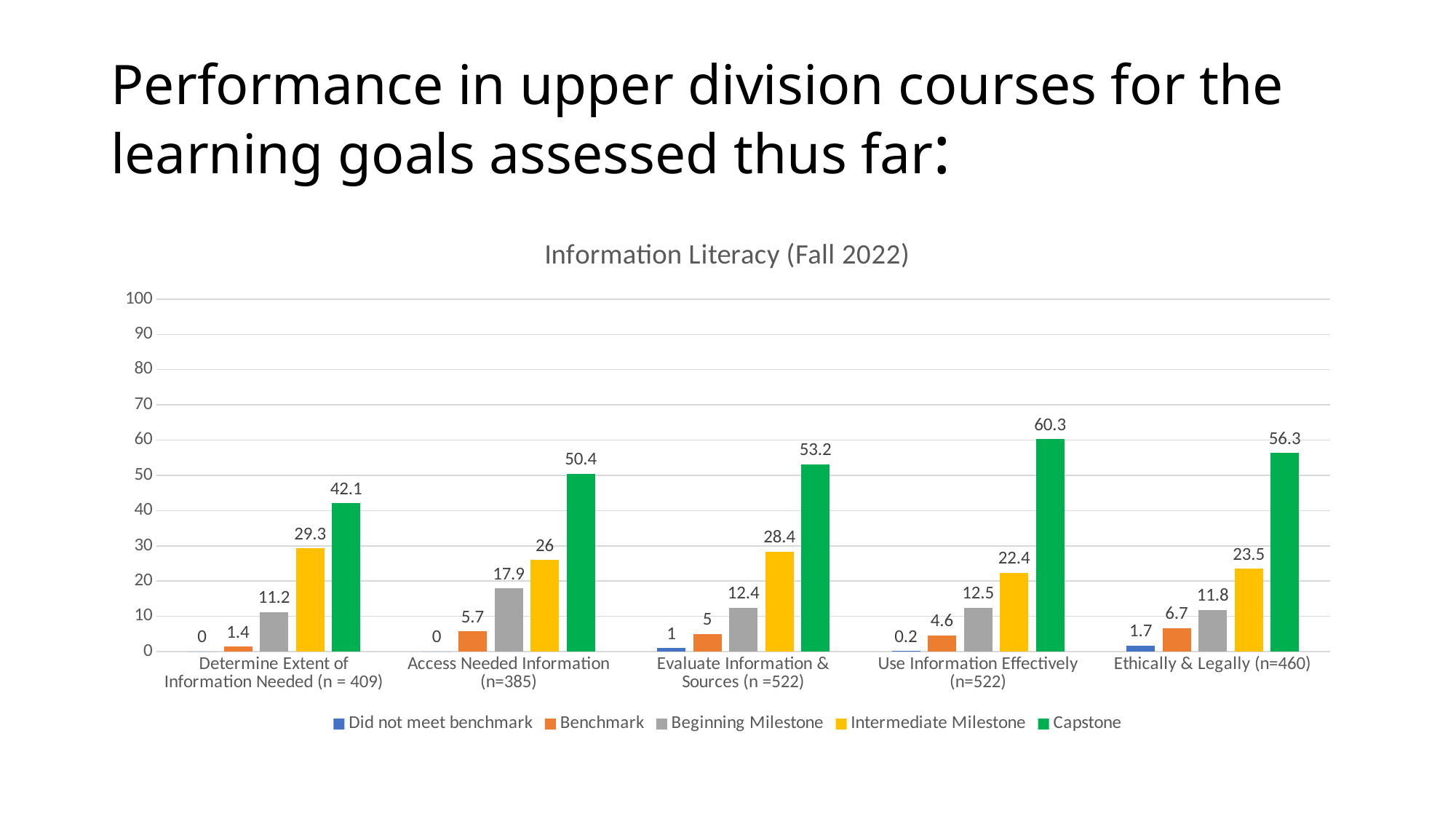
How many categories are shown on the x axis? 5 What is the Capstone value for Use Information Effectively (n=522)? 60.3 How many series does the legend list? 5 What is the Beginning Milestone value for Ethically & Legally (n=460)? 11.8 Which is larger: the Intermediate Milestone value for Determine Extent of Information Needed (n = 409) or for Evaluate Information & Sources (n =522)? Determine Extent of Information Needed (n = 409) Which category has the lowest Capstone value? Determine Extent of Information Needed (n = 409) What is the Intermediate Milestone value for Access Needed Information (n=385)? 26 What is the difference between the Capstone values for Use Information Effectively (n=522) and Determine Extent of Information Needed (n = 409)? 18.2 What is the title of the chart? Information Literacy (Fall 2022) Which category has the highest Capstone value? Use Information Effectively (n=522) What kind of chart is shown on the slide? bar chart Is the Capstone value for Ethically & Legally (n=460) greater or less than 50? greater